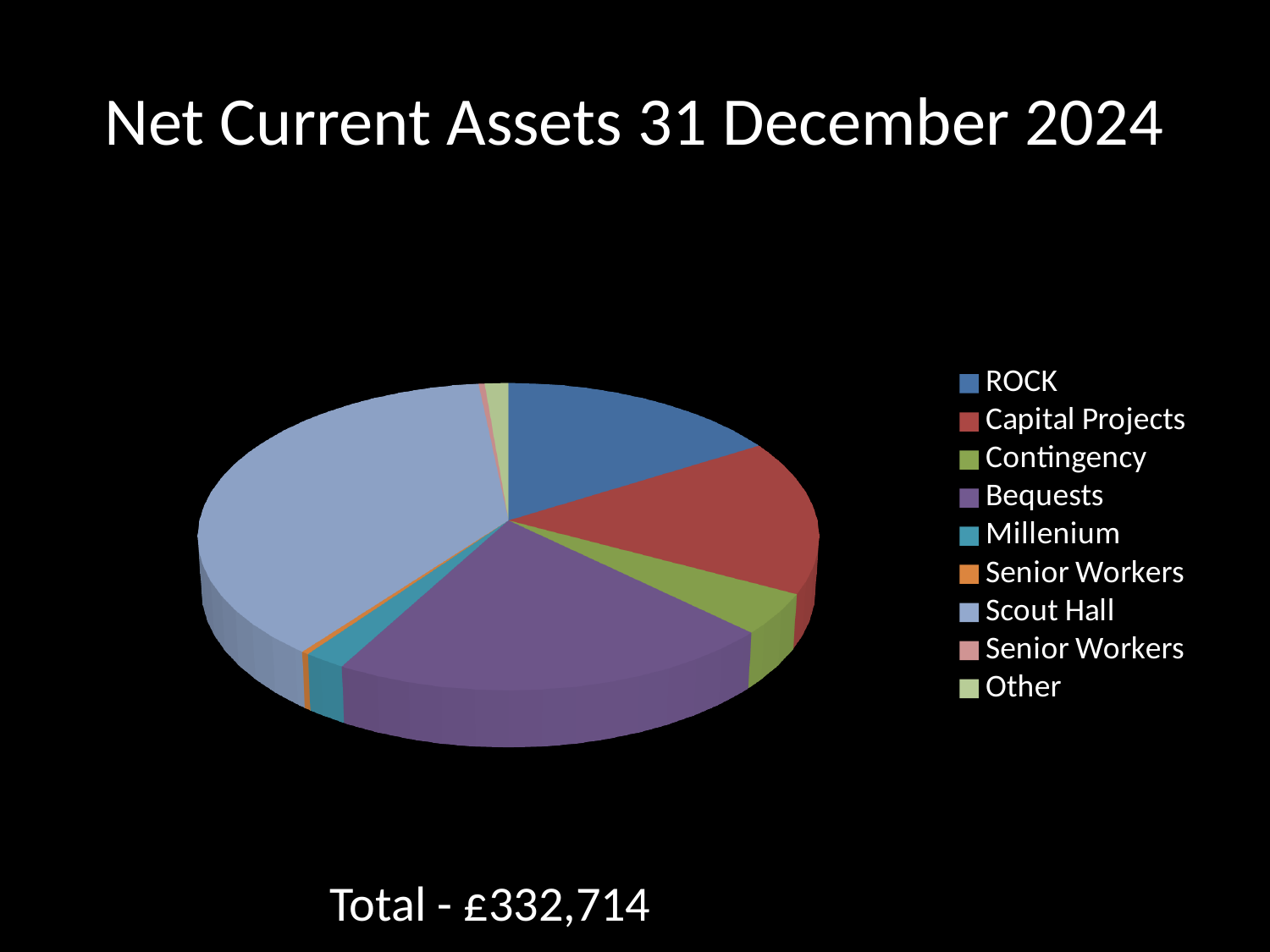
Which slice is larger, Contingency or Other? Contingency Which slice is larger, Bequests or Capital Projects? Bequests What kind of chart is shown on the slide? Pie chart What is the title of the chart? Net Current Assets 31 December 2024 Which slice is larger, Capital Projects or Millenium? Capital Projects Which category has the largest slice of the pie? Scout Hall How many categories does the legend of the pie chart list? 9 What total amount is stated below the pie chart? £332,714